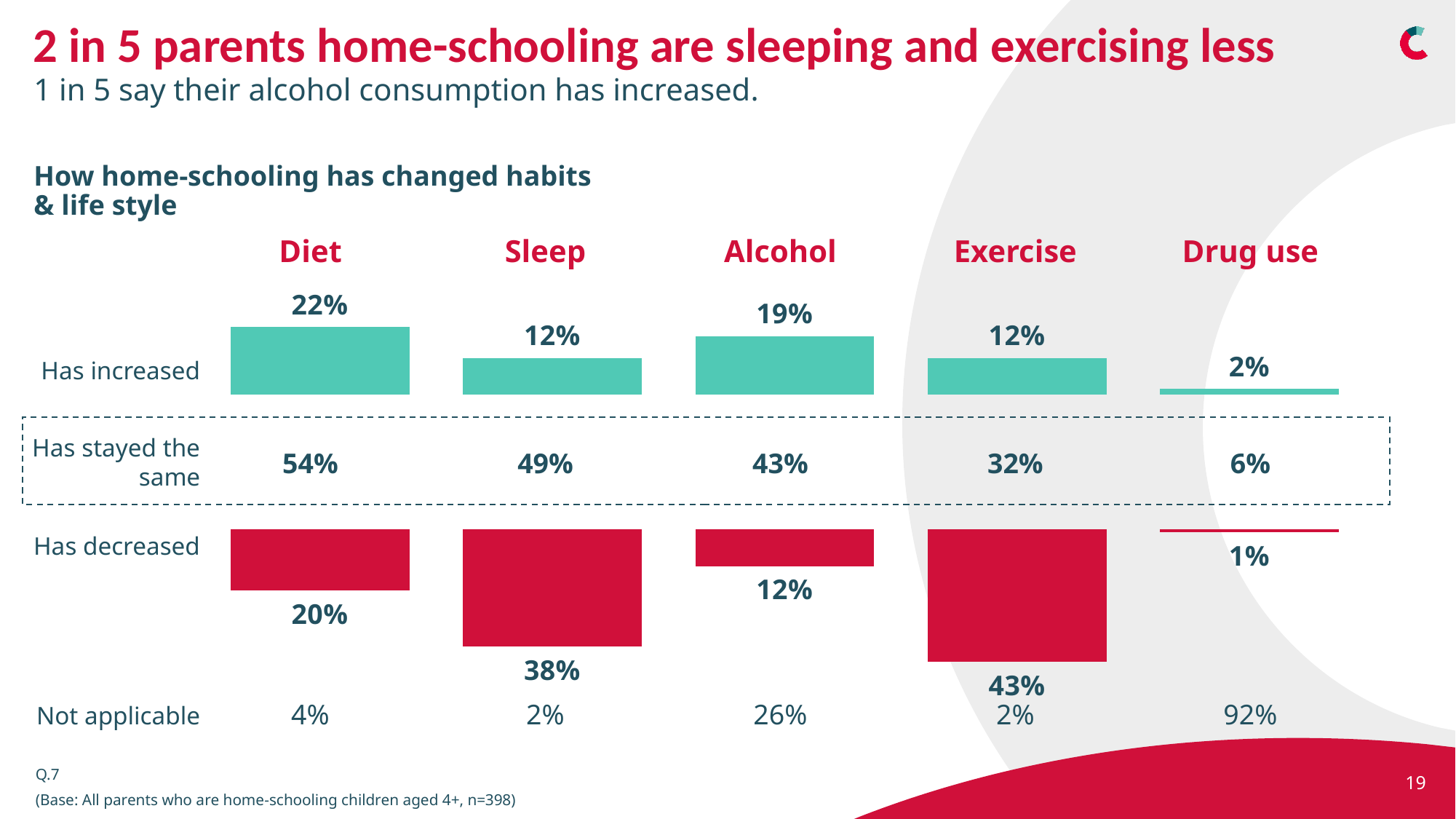
Which habit has the highest 'Has increased' percentage? Diet What is the difference between the 'Has decreased' percentages for Sleep and Alcohol? 26% What percentage of parents say their alcohol consumption has stayed the same? 43% What percentage of parents say their exercise has decreased? 43% What is the 'Not applicable' value for Drug use? 92% What colour are the 'Has decreased' bars? Red What percentage of parents say their diet has increased? 22% What type of chart is used to show the 'Has increased' and 'Has decreased' values? Bar chart Which is larger: the 'Has increased' value for Alcohol or for Sleep? Alcohol How many habit categories are shown in the chart? 5 What is the title of the chart? How home-schooling has changed habits & life style Which habit has the lowest 'Has decreased' percentage? Drug use